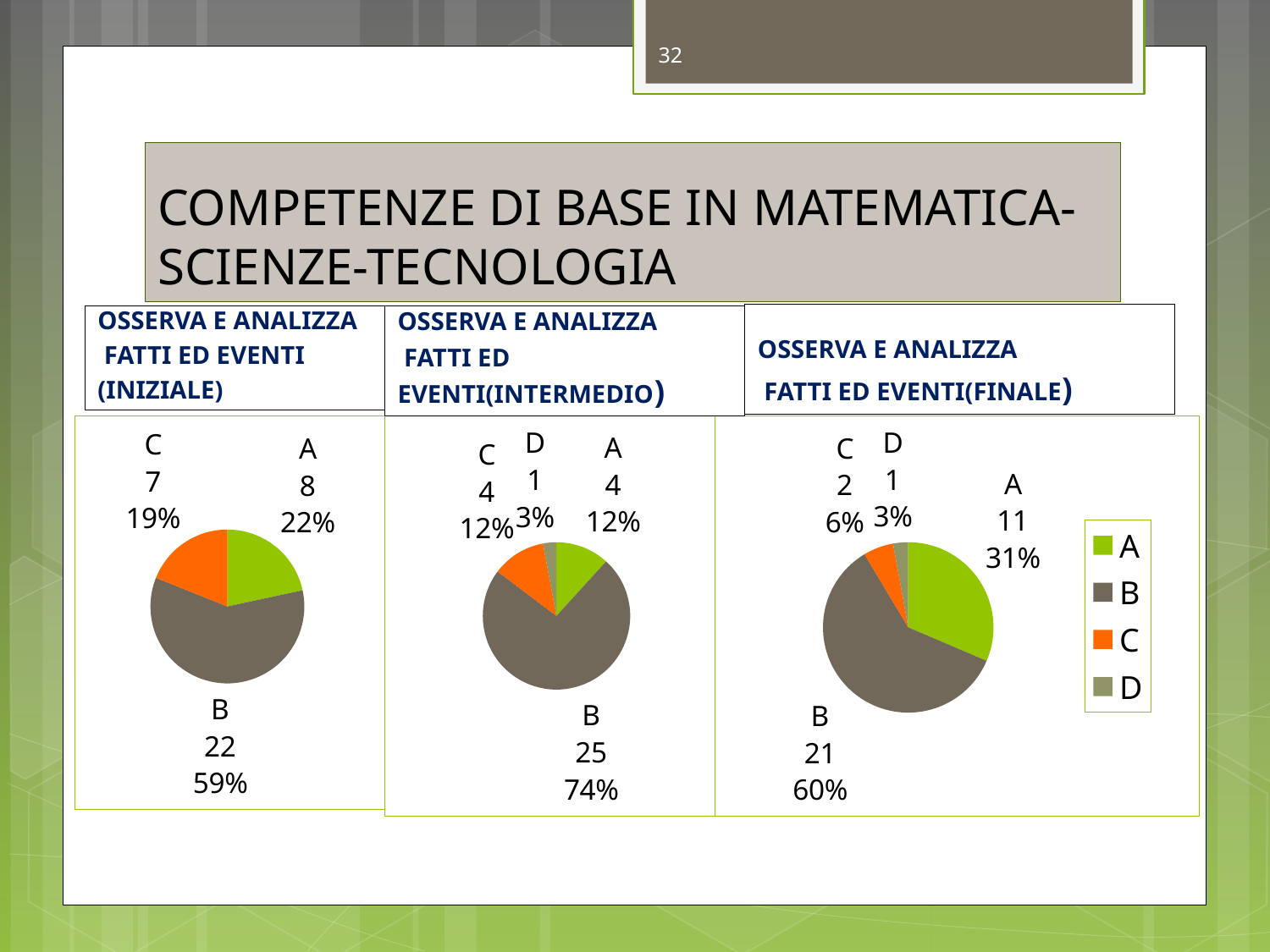
In the right pie chart (FINALE), which category has the largest slice? B In the right pie chart (FINALE), what value is shown for category A? 11 In the left pie chart (INIZIALE), what is the difference between the values for B and A? 14 In the right pie chart (FINALE), which is larger, the value for A or the value for C? A In the left pie chart (INIZIALE), what value is shown for category B? 22 In the right pie chart (FINALE), what percentage share does category C have? 6% In the middle pie chart (INTERMEDIO), what value is shown for category D? 1 In the middle pie chart (INTERMEDIO), which category has the smallest slice? D How many categories are shown in the middle pie chart (INTERMEDIO)? 4 In the left pie chart (INIZIALE), what percentage share does category C have? 19% What type of chart is used on this slide? Pie chart In the middle pie chart (INTERMEDIO), what percentage share does category B have? 74%